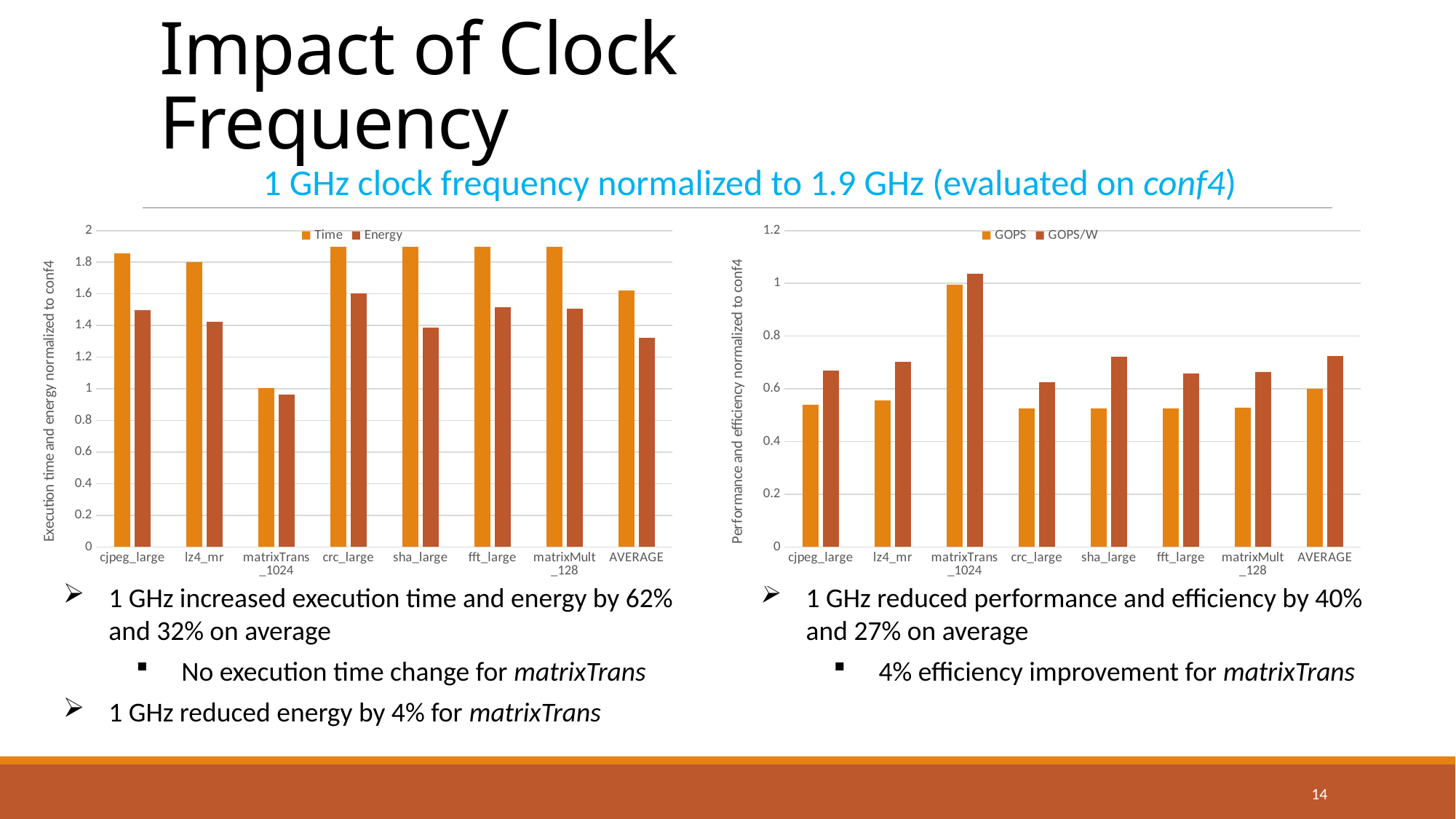
On the right chart, what are the two series named in the legend? GOPS and GOPS/W On the right chart, for sha_large, which is larger: GOPS or GOPS/W? GOPS/W On the right chart, is the GOPS/W value for matrixTrans_1024 greater or less than 1? greater On the right chart, is the GOPS value for cjpeg_large greater or less than 0.6? less On the left chart, which category has the lowest Time value? matrixTrans_1024 On the left chart, how many categories are shown on the x axis? 8 On the left chart, how many series does the legend list? 2 On the left chart, which category has the highest Energy value? crc_large On the left chart, is the Energy value for AVERAGE greater or less than 1.2? greater What kind of chart is the right chart? Bar chart On the right chart, which category has the highest GOPS value? matrixTrans_1024